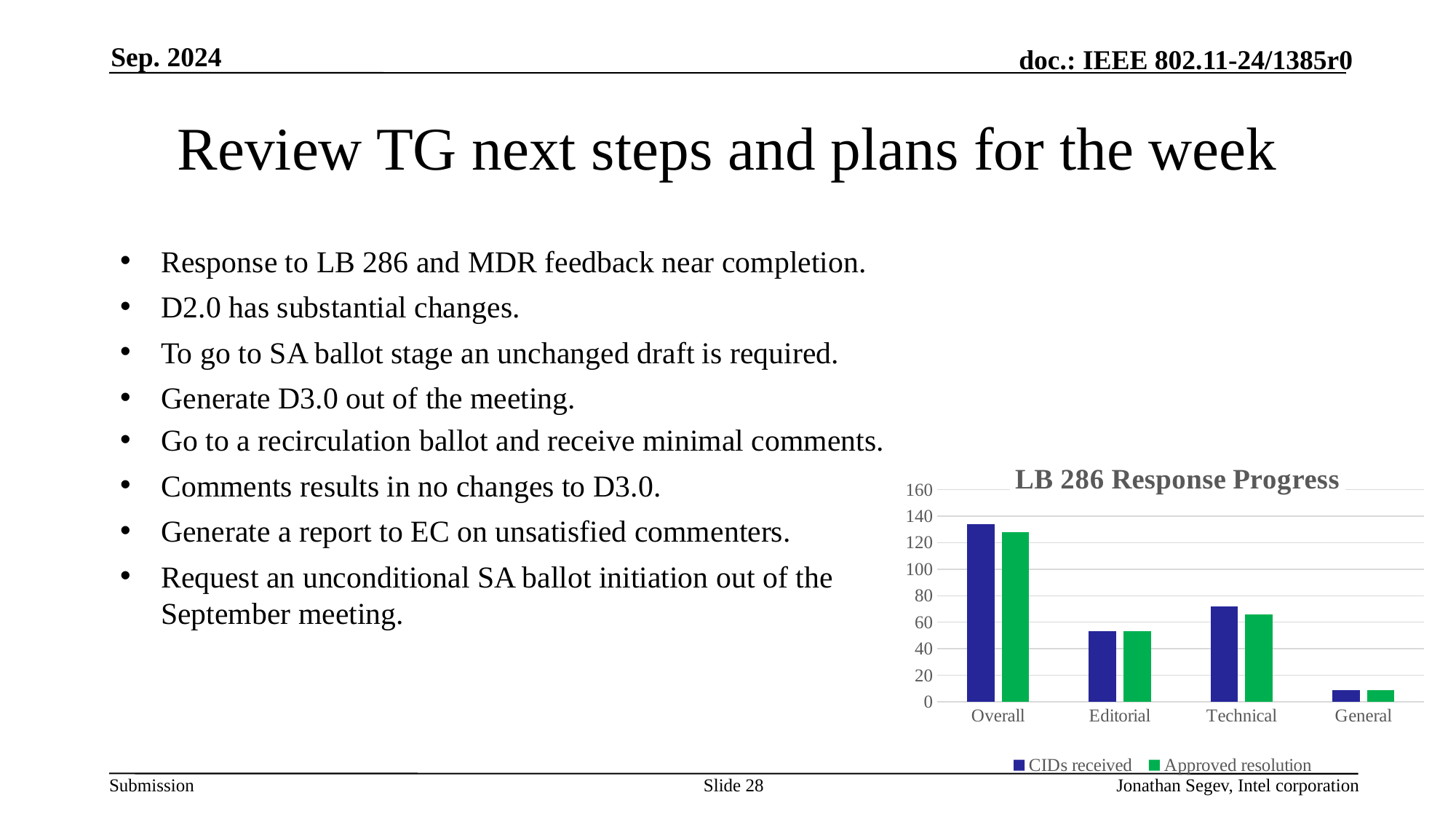
Which category has the lowest value for 'Approved resolution'? General Is the value for 'CIDs received' in the Editorial category greater or less than 60? less Which category has the larger value for 'CIDs received', Editorial or Technical? Technical Which colour represents the 'Approved resolution' series in the chart? green Is the value for 'CIDs received' in the Technical category greater or less than 60? greater Is the value for 'CIDs received' in the Overall category greater or less than 120? greater How many series does the chart's legend list? 2 What is the title of the chart on the slide? LB 286 Response Progress Which category has the highest value for 'CIDs received'? Overall What kind of chart is shown on the slide? bar chart How many categories are shown on the x axis of the chart? 4